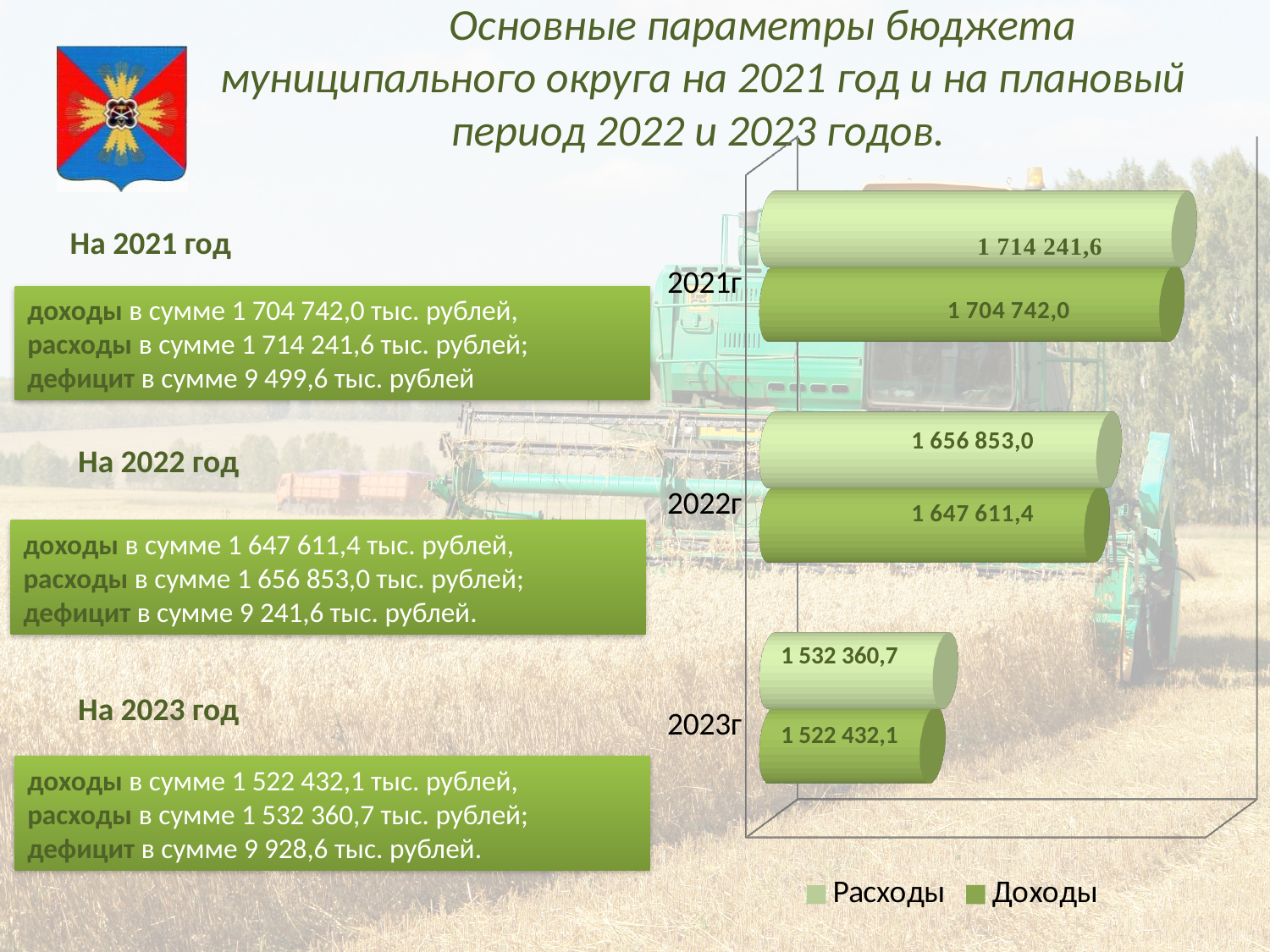
What is the difference between Расходы and Доходы for 2021г? 9 499,6 What is the value of Доходы for 2023г? 1 522 432,1 Which is larger for 2022г: Расходы or Доходы? Расходы How many years (categories) are shown in the chart? 3 What type of chart is shown on the slide? Bar chart Which year has the highest value of Расходы? 2021г How many series does the legend list? 2 Which year has the lowest value of Доходы? 2023г What is the value of Расходы for 2022г? 1 656 853,0 What is the value of Расходы for 2021г? 1 714 241,6 What is the value of Доходы for 2022г? 1 647 611,4 What is the difference between Расходы and Доходы for 2023г? 9 928,6